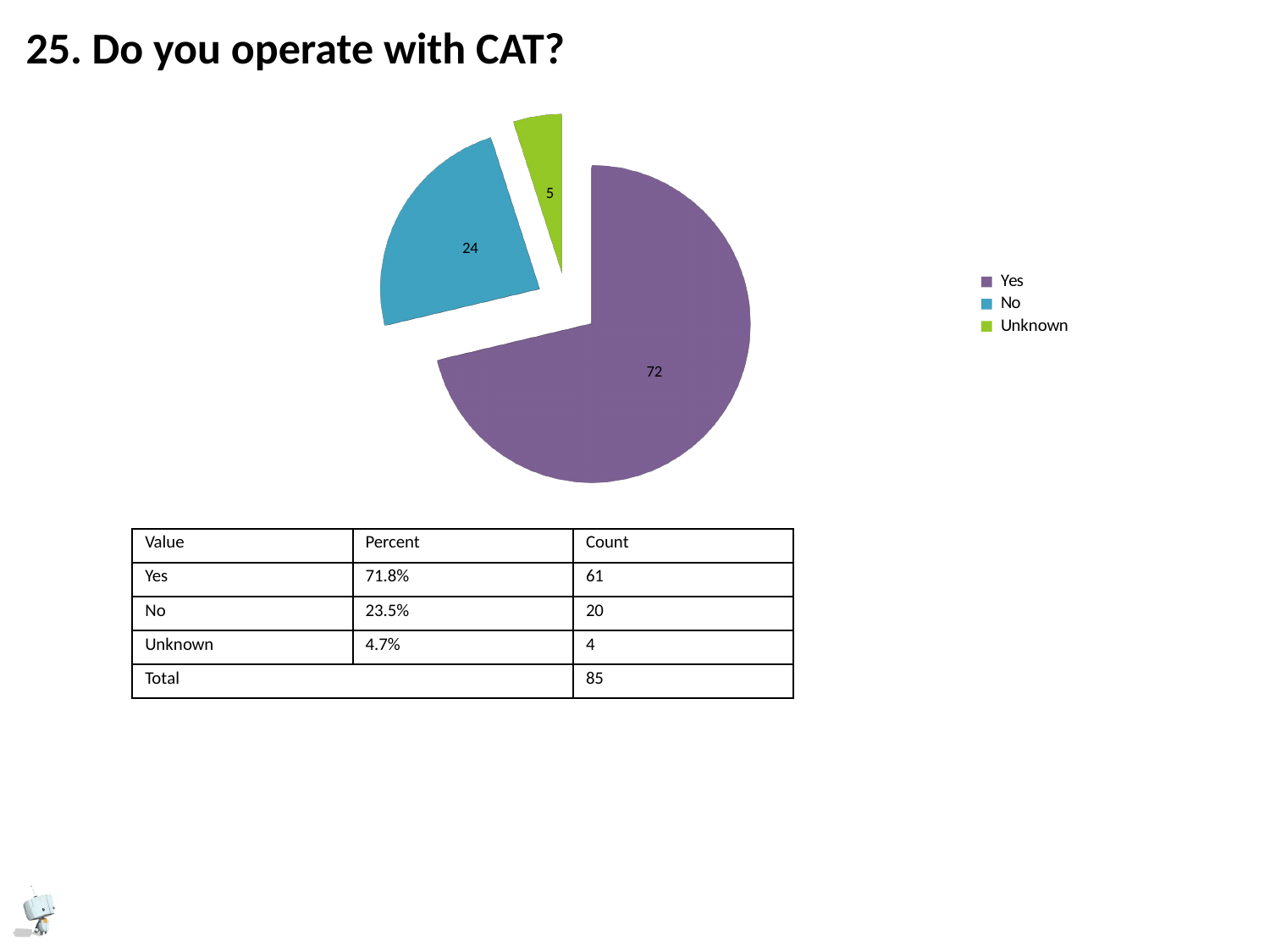
Which slice of the pie chart is the smallest? Unknown What is the data label on the Yes slice of the pie chart? 72 Which slice has a larger data label, No or Unknown? No What is the title of the slide containing the pie chart? 25. Do you operate with CAT? What kind of chart is shown on the slide? pie chart What colour is the Yes slice of the pie chart? purple How many entries does the legend list? 3 What is the data label on the Unknown slice of the pie chart? 5 Which slice of the pie chart is the largest? Yes What is the data label on the No slice of the pie chart? 24 How many slices does the pie chart have? 3 What is the difference between the data labels of the Yes and No slices? 48